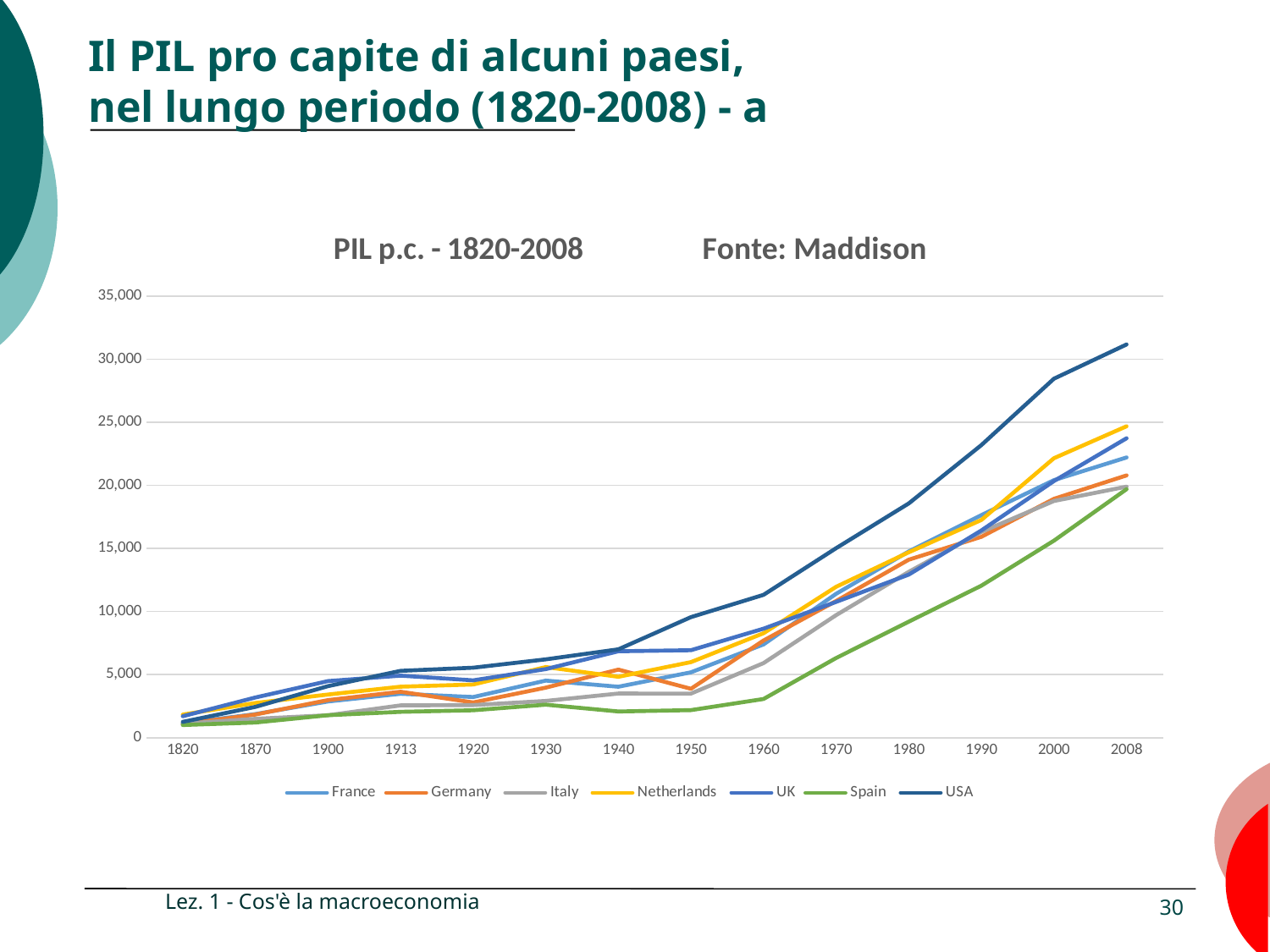
What is the source cited in the chart title? Maddison In 1990, which is larger, the value for USA or the value for Spain? USA Is the value for Spain in 1960 greater or less than 5,000? less Which country has the highest GDP per capita in 1990? USA Is the value for USA in 2000 greater or less than 25,000? greater Which country has the lowest GDP per capita in 1970? Spain Is the value for USA in 2008 greater or less than 30,000? greater How many series does the legend list? 7 How many years are marked on the x axis? 14 Does the USA series rise or fall from 1820 to 2008? rise What kind of chart is shown on the slide? line chart Which country has the highest GDP per capita in 2008? USA